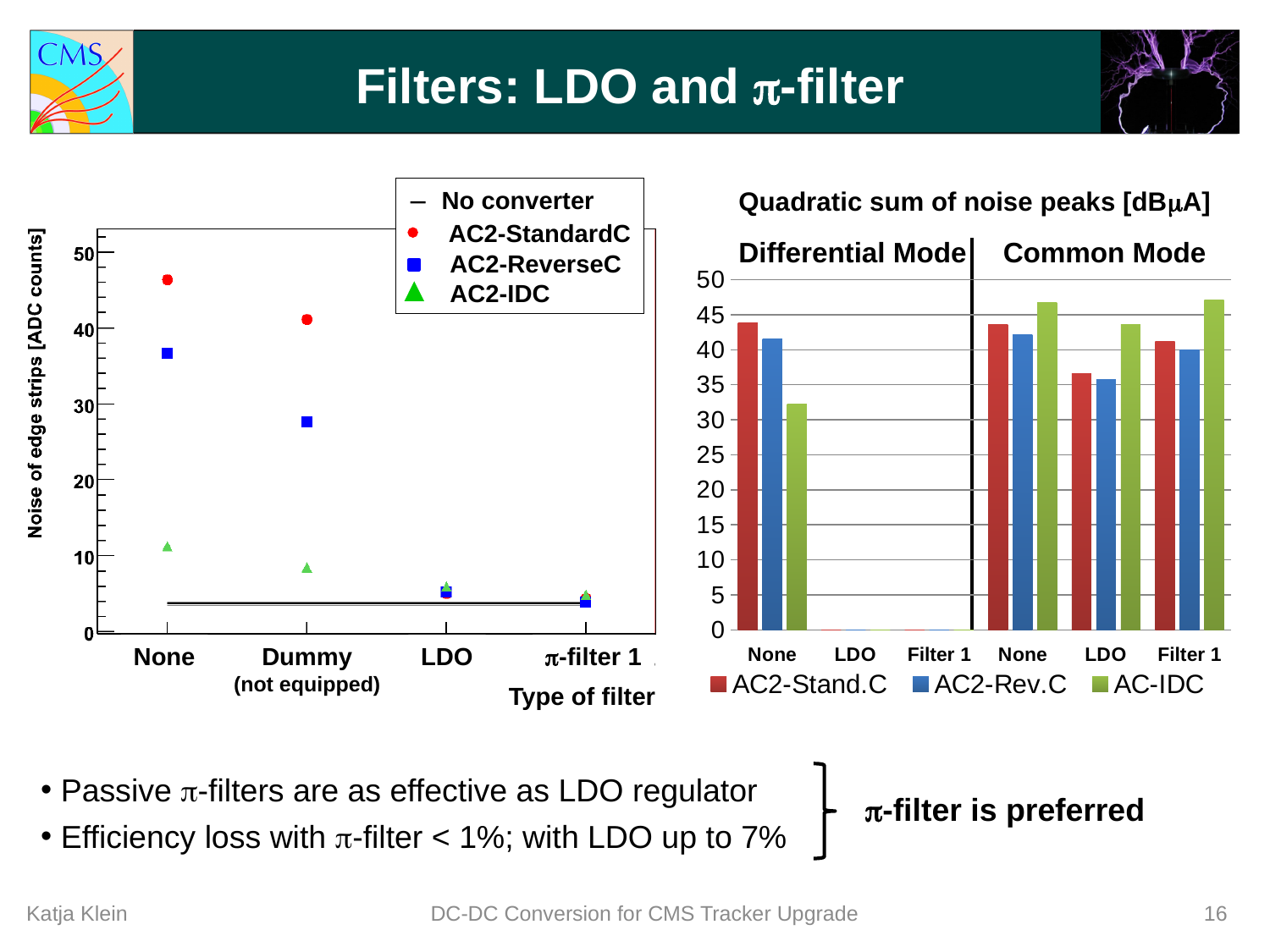
In the right-hand chart 'Quadratic sum of noise peaks [dBμA]', is the AC-IDC value for None in Differential Mode greater or less than 35? less In the left-hand chart 'Noise of edge strips [ADC counts]', is the AC2-StandardC value for None greater or less than 40? greater In the right-hand chart 'Quadratic sum of noise peaks [dBμA]', how many series does the legend list? 3 In the right-hand chart 'Quadratic sum of noise peaks [dBμA]', which series has the lowest value for None in Differential Mode? AC-IDC In the left-hand chart 'Noise of edge strips [ADC counts]', which series has the highest value for None? AC2-StandardC In the right-hand chart 'Quadratic sum of noise peaks [dBμA]', is the AC-IDC value for LDO in Common Mode greater or less than 40? greater What kind of chart is the right-hand chart titled 'Quadratic sum of noise peaks [dBμA]'? bar chart In the right-hand chart 'Quadratic sum of noise peaks [dBμA]', which is larger for AC2-Stand.C in Common Mode: None or LDO? None In the right-hand chart 'Quadratic sum of noise peaks [dBμA]', which series has the highest value for Filter 1 in Common Mode? AC-IDC In the left-hand chart 'Noise of edge strips [ADC counts]', do the AC2-StandardC values rise or fall from None to π-filter 1? fall In the left-hand chart 'Noise of edge strips [ADC counts]', how many entries does the legend list? 4